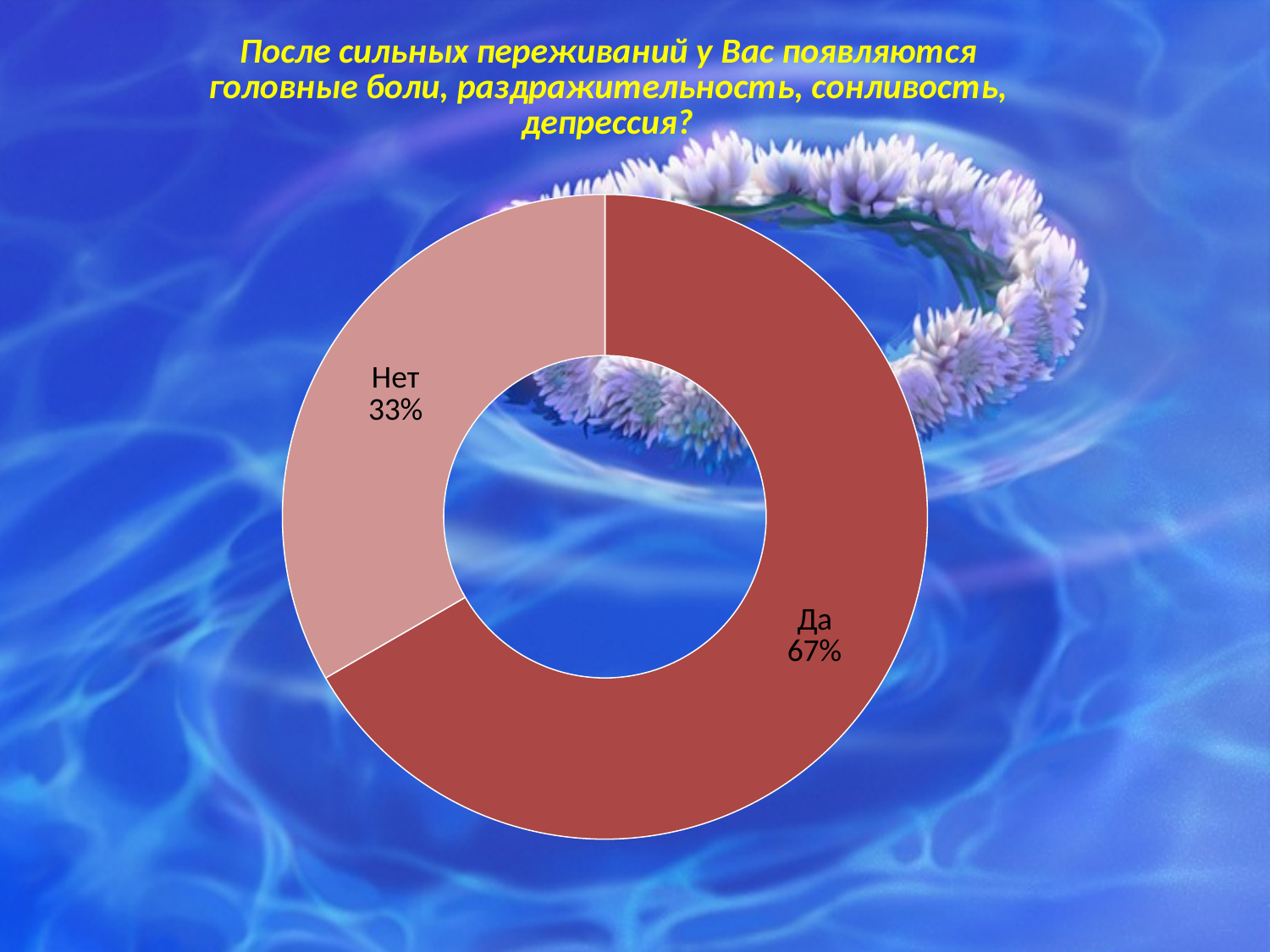
What percentage of respondents answered "Нет"? 33% What percentage of respondents answered "Да"? 67% How many categories are shown in the chart? 2 What kind of chart is shown on the slide? Doughnut (pie) chart Which slice is shown in the darker red colour? Да What question is the chart answering, according to the slide title? После сильных переживаний у Вас появляются головные боли, раздражительность, сонливость, депрессия? What is the difference in percentage points between the "Да" and "Нет" shares? 34 Which answer has the largest share of the chart? Да Which is larger, the share for "Да" or the share for "Нет"? Да Which answer has the smallest share of the chart? Нет What share of the chart does the "Нет" slice represent? 33%